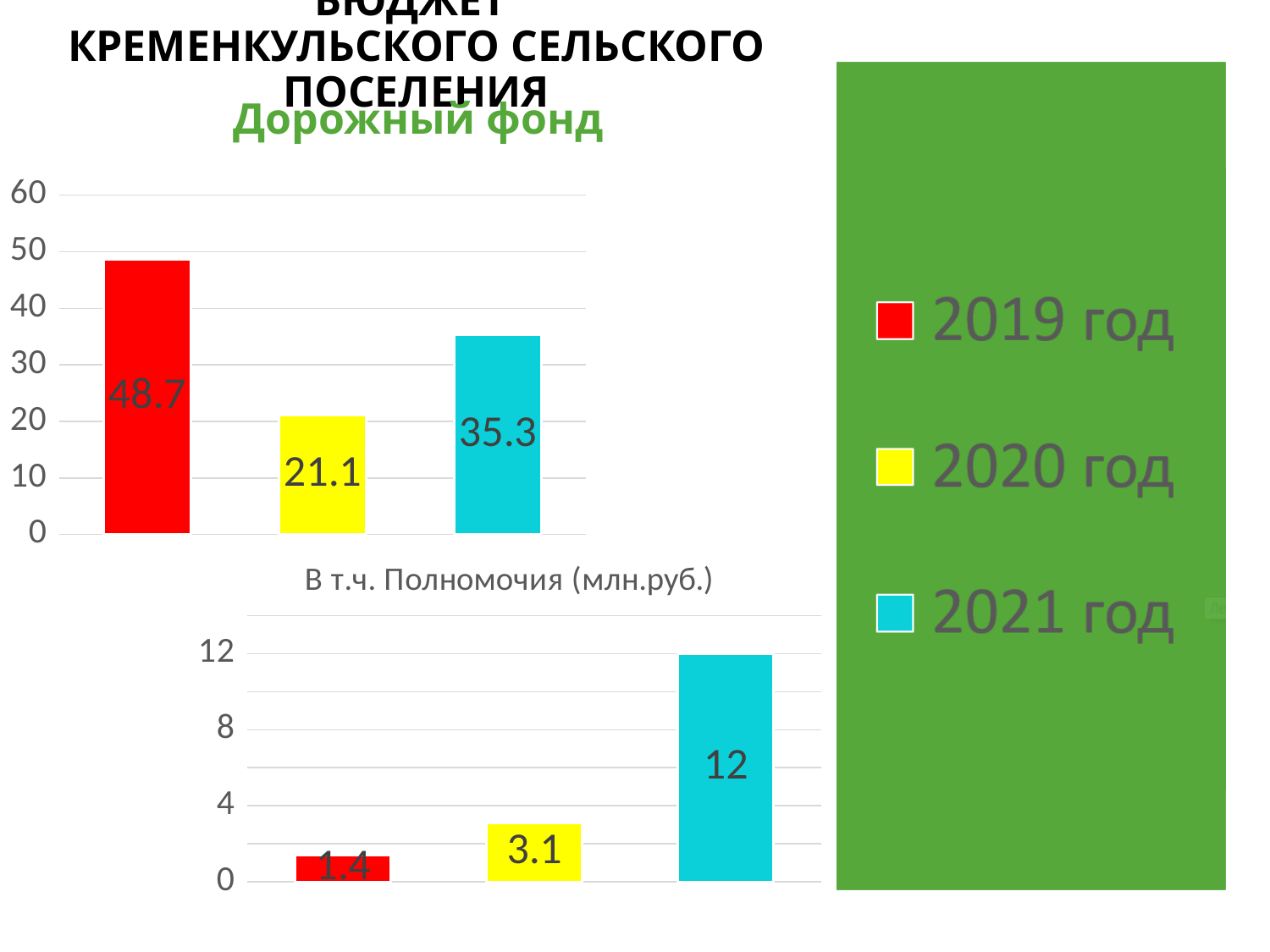
What type of chart is the 'Дорожный фонд' chart? Bar chart How many years does the legend on the slide list? 3 In the 'В т.ч. Полномочия (млн.руб.)' chart, which year has the highest value? 2021 год In the 'В т.ч. Полномочия (млн.руб.)' chart, what is the difference between the 2021 год and 2020 год values? 8.9 In the 'Дорожный фонд' chart, what is the value for 2020 год? 21.1 In the 'В т.ч. Полномочия (млн.руб.)' chart, what is the value for 2019 год? 1.4 In the 'Дорожный фонд' chart, what is the value for 2019 год? 48.7 In the 'Дорожный фонд' chart, which year has the highest value? 2019 год In the 'В т.ч. Полномочия (млн.руб.)' chart, what is the value for 2021 год? 12 In the 'В т.ч. Полномочия (млн.руб.)' chart, which is larger, the value for 2020 год or 2019 год? 2020 год In the 'Дорожный фонд' chart, which year has the lowest value? 2020 год In the 'Дорожный фонд' chart, what is the difference between the 2019 год and 2021 год values? 13.4